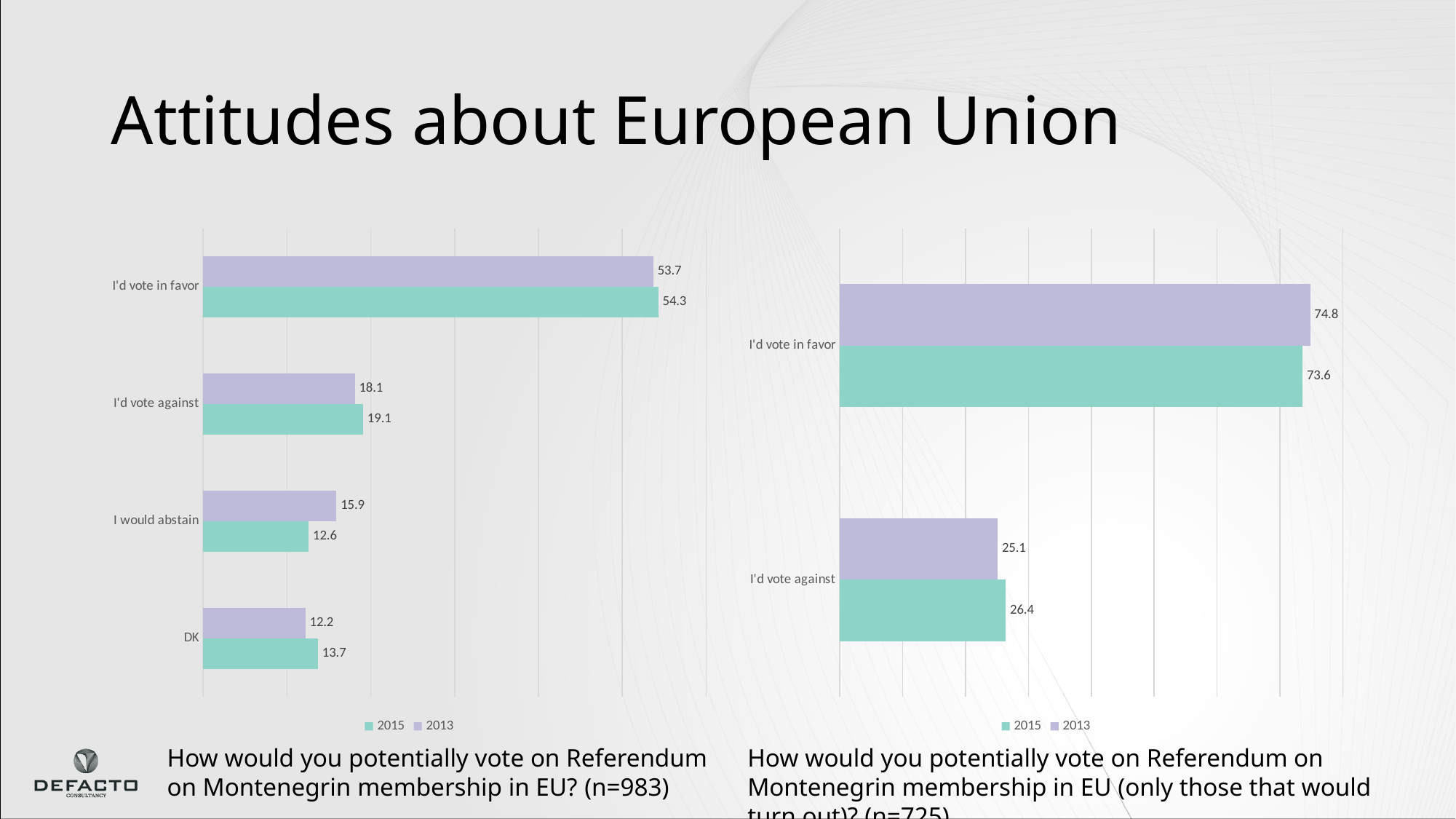
In the right chart (n=725), what is the 2013 value for "I'd vote in favor"? 74.8 What type of chart is the right chart (n=725)? Bar chart How many series does the legend of the right chart (n=725) list? 2 In the left chart (n=983), what is the difference between the 2013 and 2015 values for "I would abstain"? 3.3 How many categories are shown in the left chart (n=983)? 4 In the left chart (n=983), which is larger for "DK": the 2015 value or the 2013 value? 2015 In the right chart (n=725), what is the difference between the 2013 and 2015 values for "I'd vote in favor"? 1.2 In the right chart (n=725), what is the 2015 value for "I'd vote against"? 26.4 In the left chart (n=983), what is the 2015 value for "I'd vote in favor"? 54.3 In the left chart (n=983), which category has the lowest 2013 value? DK In the left chart (n=983), what is the 2013 value for "I would abstain"? 15.9 In the left chart (n=983), which category has the highest 2015 value? I'd vote in favor